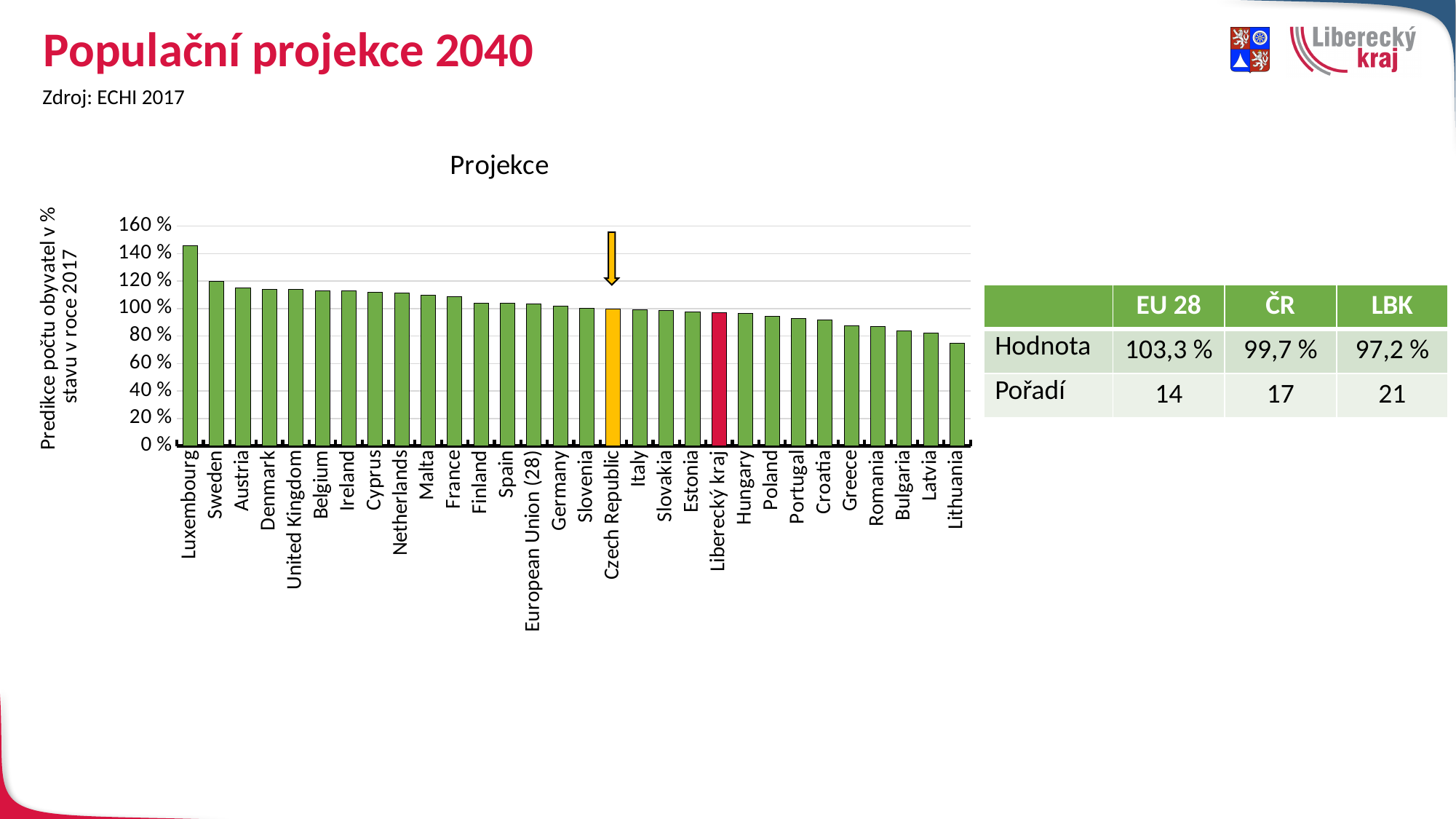
How many countries/regions are shown as bars in the chart? 30 Which category has the highest bar in the chart? Luxembourg Is the value for Lithuania greater or less than 80 %? less Which has the larger value, Luxembourg or Sweden? Luxembourg What is the title of the chart? Projekce Do the bar values rise or fall from left to right along the x axis? fall Is the value for Greece greater or less than 100 %? less What colour is the bar for Liberecký kraj? red What kind of chart is shown on the slide? bar chart According to the table, what is the value (Hodnota) for ČR? 99,7 % Which category has the lowest bar in the chart? Lithuania Is the value for Luxembourg greater or less than 120 %? greater